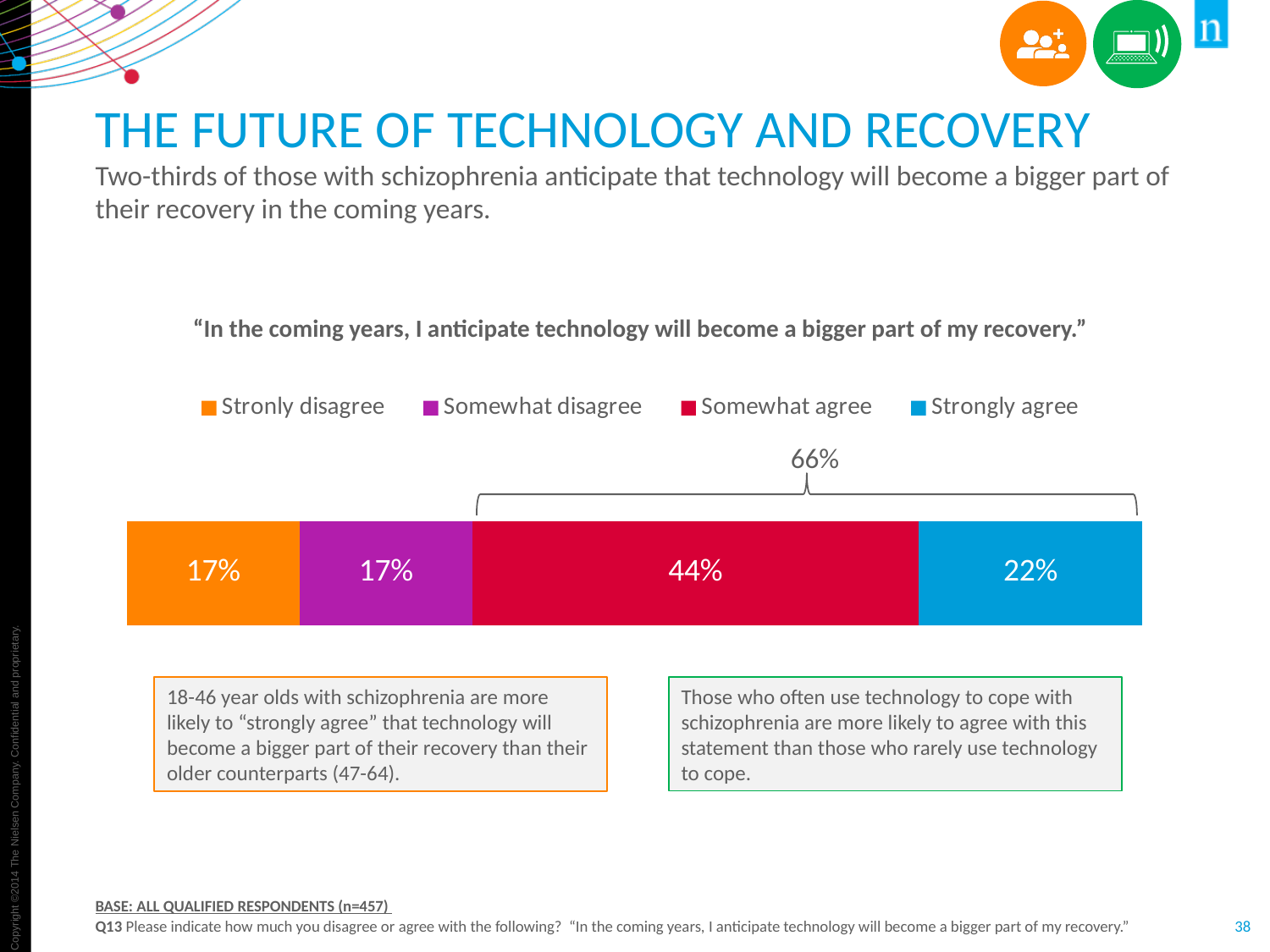
What type of chart is used to show the responses? Stacked bar chart What percentage of respondents somewhat disagree with the statement? 17% What percentage of respondents strongly agree with the statement? 22% What is the total of the 'Stronly disagree' and 'Somewhat disagree' segments? 34% What combined percentage of respondents agree (somewhat or strongly) with the statement, as shown by the bracket above the bar? 66% What colour is the 'Somewhat agree' segment of the bar? Red How many series does the legend list? 4 What is the difference in percentage points between 'Somewhat agree' and 'Strongly agree'? 22 How many response categories are shown in the stacked bar? 4 Which response category has the largest share of respondents? Somewhat agree Which is larger, the share who strongly agree or the share who strongly disagree? Strongly agree What percentage of respondents somewhat agree that technology will become a bigger part of their recovery? 44%